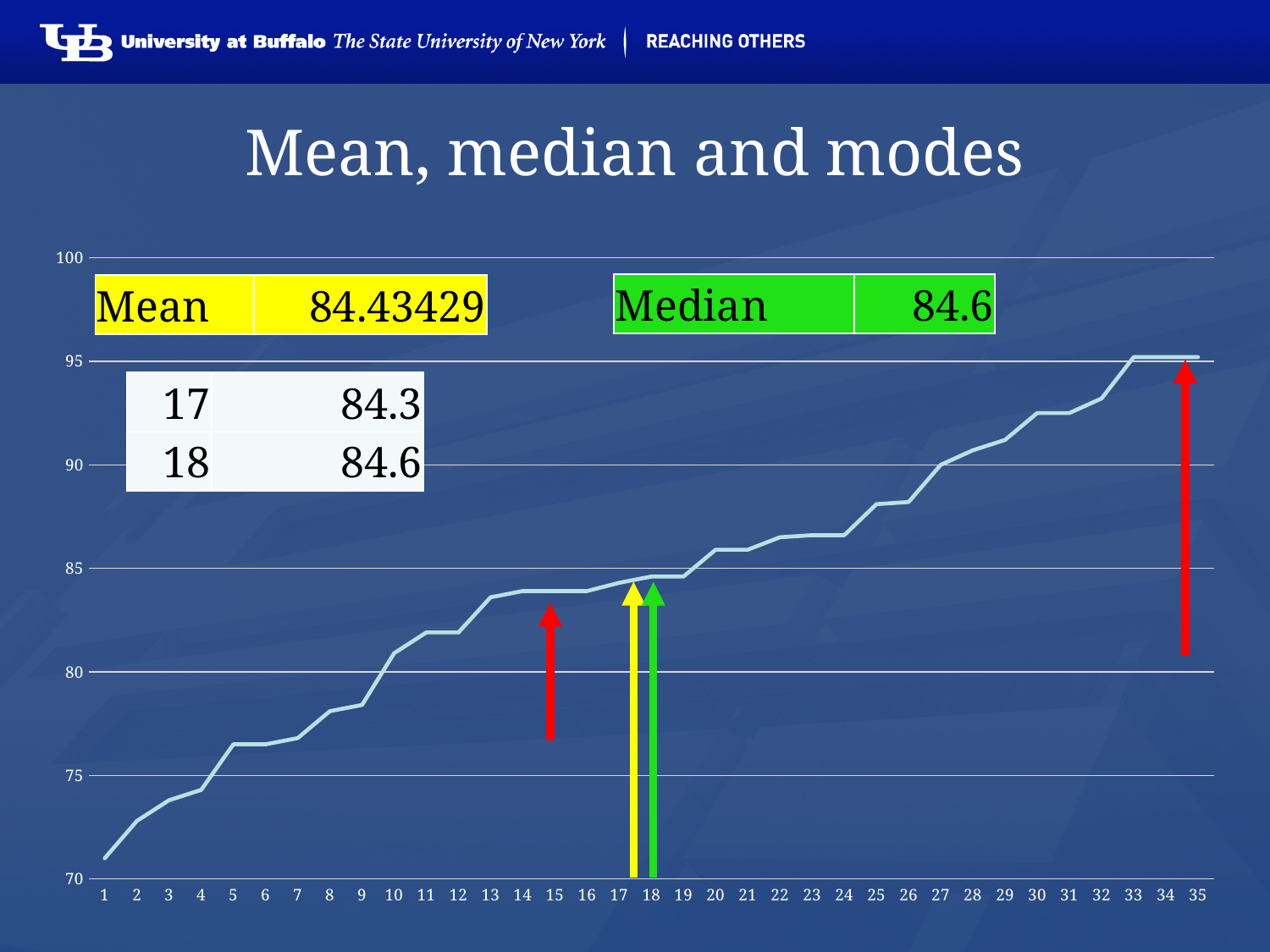
What median value is shown in the green box on the chart? 84.6 What mean value is shown in the yellow box on the chart? 84.43429 Is the value at point 1 greater or less than 75? less What is the value at point 18, as shown in the table on the chart? 84.6 What is the difference between the values at points 18 and 17? 0.3 Is the value at point 30 greater or less than 90? greater What is the value at point 17, as shown in the table on the chart? 84.3 How many points are plotted along the x axis of the chart? 35 Which point on the x axis has the lowest value? 1 What kind of chart is shown on the slide? line chart Do the plotted values rise or fall as the x axis goes from 1 to 35? rise Which has the larger value, point 17 or point 18? 18